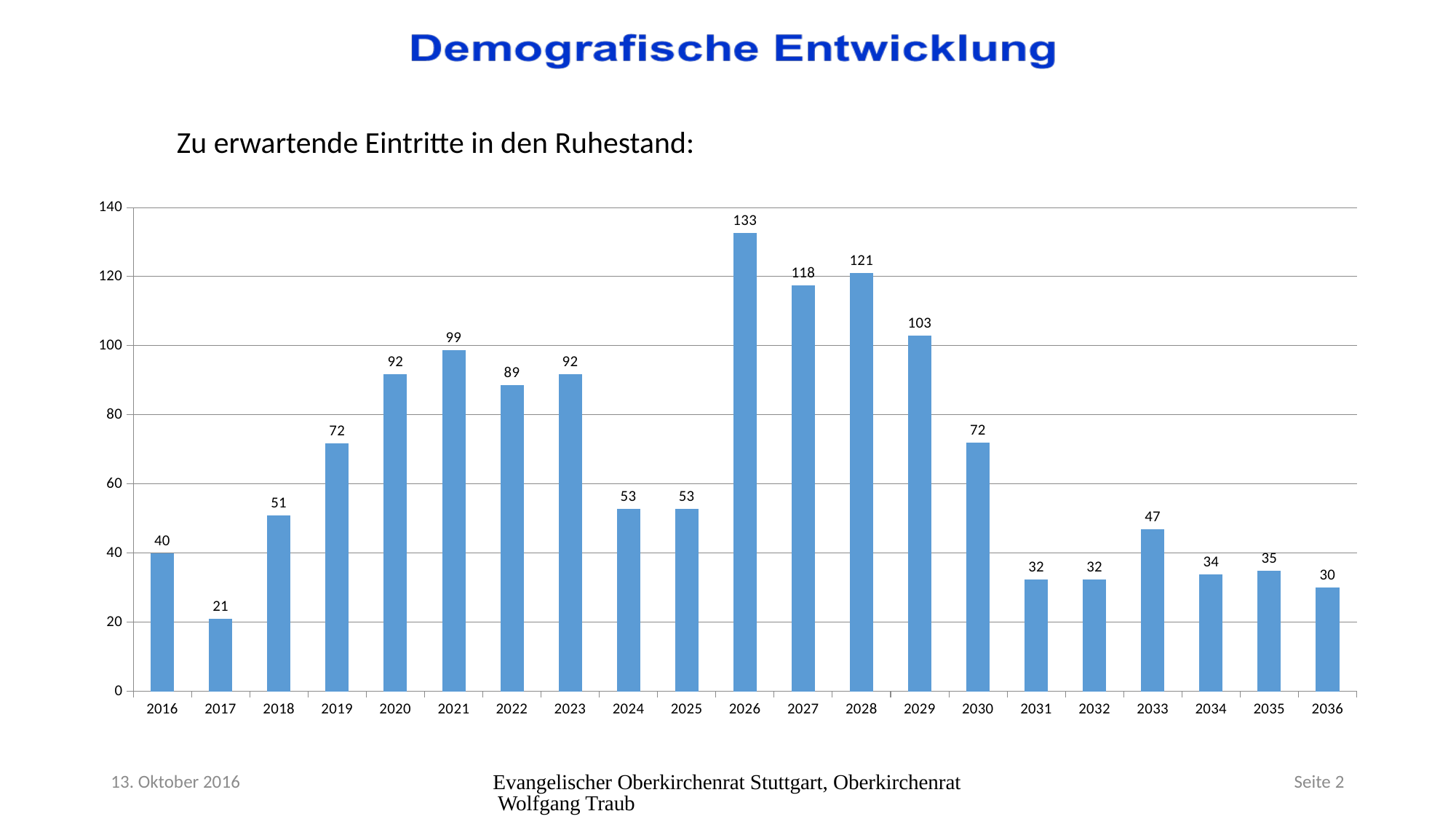
How many years are shown on the x axis? 21 What is the difference between the values for 2030 and 2031? 40 Is the value for 2028 greater or less than 100? greater Do the values rise or fall from 2031 to 2033? rise What kind of chart is shown on the slide? bar chart What is the value for 2029? 103 What is the value for 2017? 21 Which year has the highest value? 2026 Which year has the lowest value? 2017 Which is larger, the value for 2021 or the value for 2023? 2021 What is the value for 2026? 133 What is the difference between the values for 2026 and 2027? 15